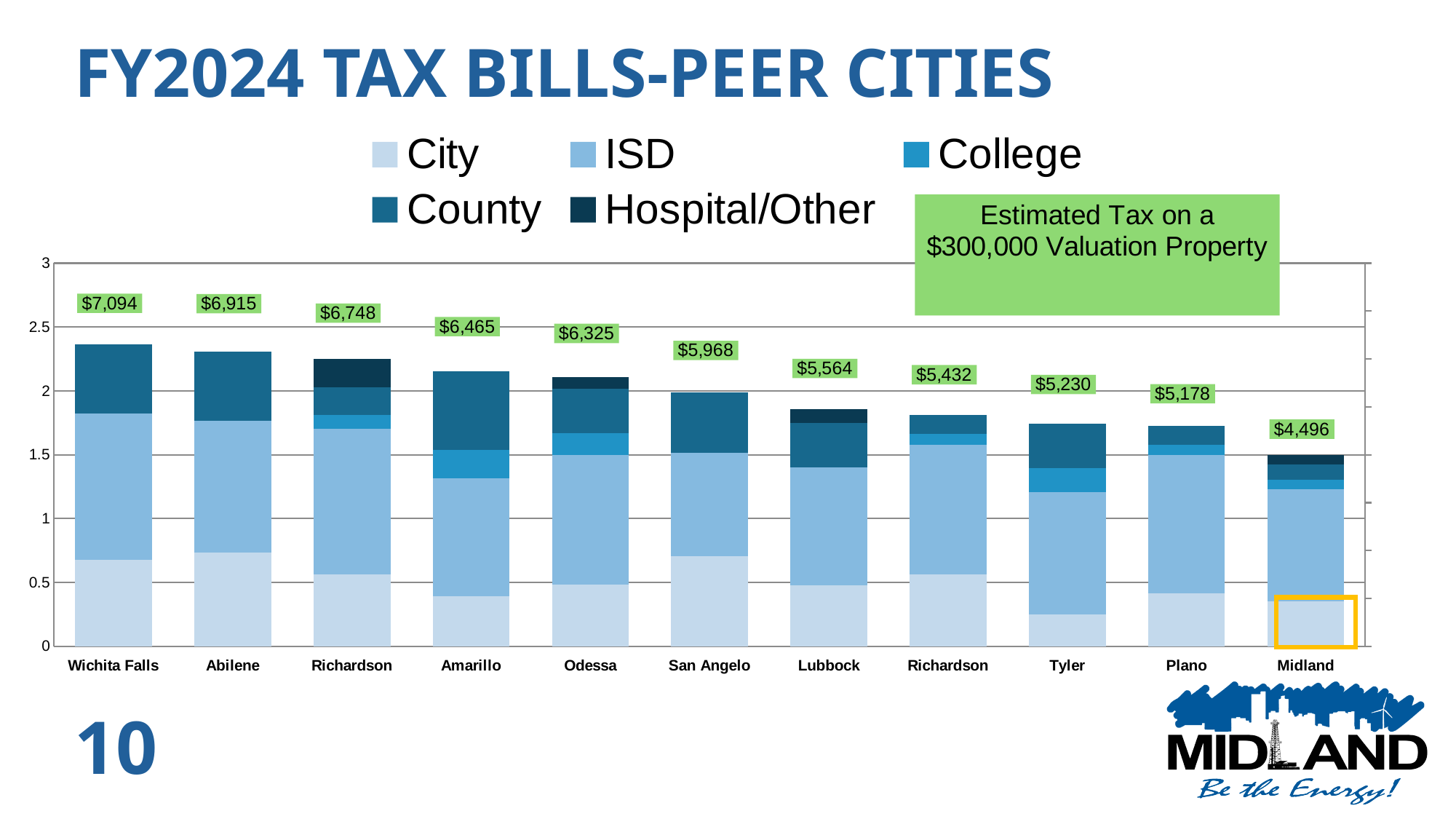
What is the estimated tax label shown above the Midland bar? $4,496 Which city has the highest estimated tax bill on the chart? Wichita Falls How many series does the legend list? 5 How many cities are shown on the x axis of the chart? 11 Which has the larger estimated tax label, Tyler or Plano? Tyler Do the estimated tax labels rise or fall moving from left to right across the chart? Fall Which city has the lowest estimated tax bill on the chart? Midland What is the estimated tax label shown above the Lubbock bar? $5,564 What is the estimated tax label shown above the Wichita Falls bar? $7,094 What is the difference between the estimated tax labels for Wichita Falls and Midland? $2,598 Is the total height of the Wichita Falls stacked bar greater or less than 2 on the y axis? greater What kind of chart is shown on the slide? Stacked bar chart